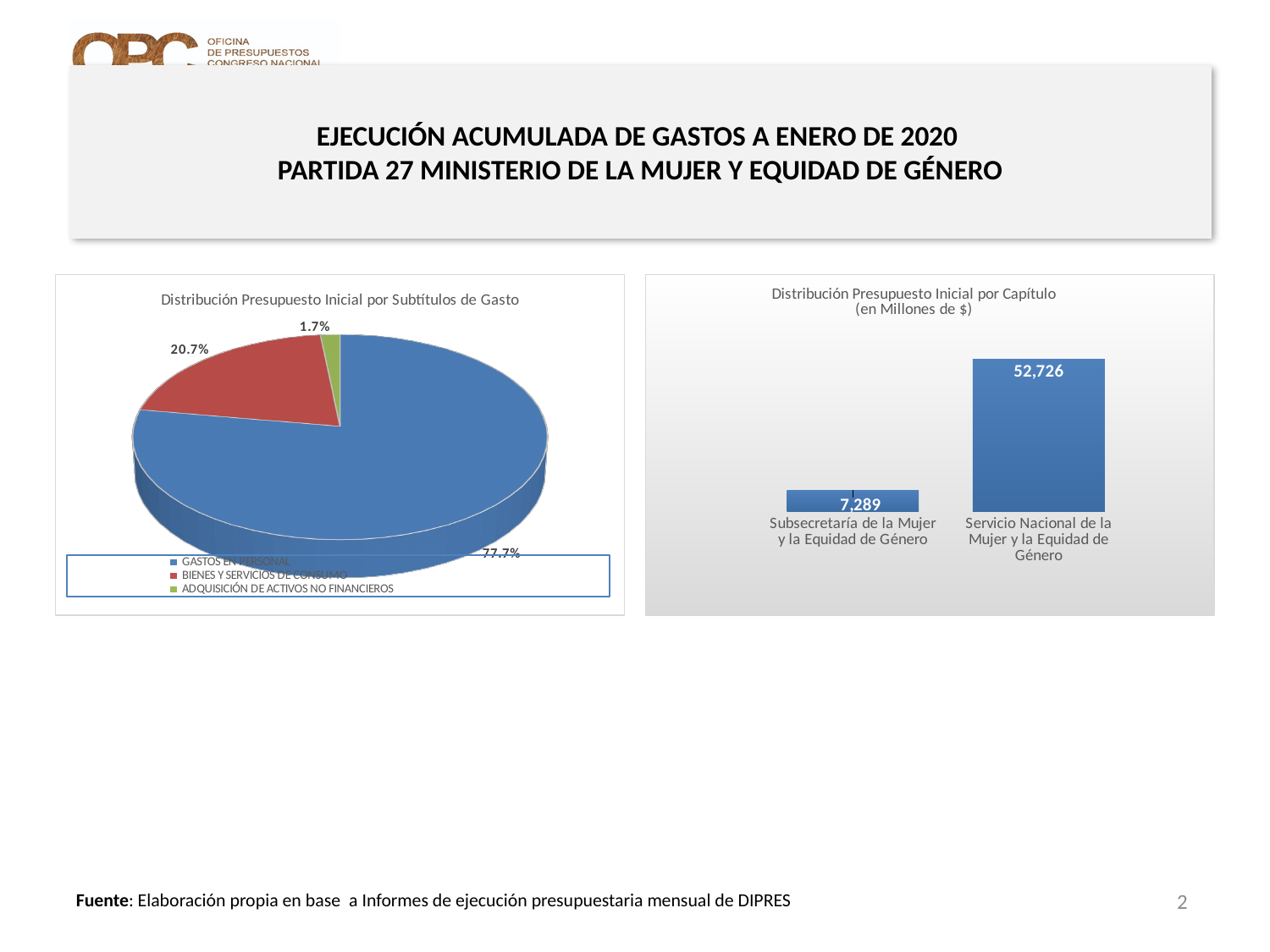
What kind of chart is 'Distribución Presupuesto Inicial por Capítulo'? Bar chart In the chart 'Distribución Presupuesto Inicial por Subtítulos de Gasto', which category has the largest slice? GASTOS EN PERSONAL In the chart 'Distribución Presupuesto Inicial por Subtítulos de Gasto', what share of the pie does ADQUISICIÓN DE ACTIVOS NO FINANCIEROS represent? 1.7% In the chart 'Distribución Presupuesto Inicial por Capítulo', what is the value for Servicio Nacional de la Mujer y la Equidad de Género? 52,726 In the chart 'Distribución Presupuesto Inicial por Subtítulos de Gasto', which category has the smallest slice? ADQUISICIÓN DE ACTIVOS NO FINANCIEROS In the chart 'Distribución Presupuesto Inicial por Subtítulos de Gasto', what share of the pie does BIENES Y SERVICIOS DE CONSUMO represent? 20.7% In the chart 'Distribución Presupuesto Inicial por Capítulo', what unit is stated in the title? Millones de $ In the chart 'Distribución Presupuesto Inicial por Subtítulos de Gasto', what share of the pie does GASTOS EN PERSONAL represent? 77.7% In the chart 'Distribución Presupuesto Inicial por Subtítulos de Gasto', how many categories does the legend list? 3 In the chart 'Distribución Presupuesto Inicial por Capítulo', what is the difference between the values for Servicio Nacional de la Mujer y la Equidad de Género and Subsecretaría de la Mujer y la Equidad de Género? 45,437 In the chart 'Distribución Presupuesto Inicial por Capítulo', what is the value for Subsecretaría de la Mujer y la Equidad de Género? 7,289 What kind of chart is 'Distribución Presupuesto Inicial por Subtítulos de Gasto'? Pie chart